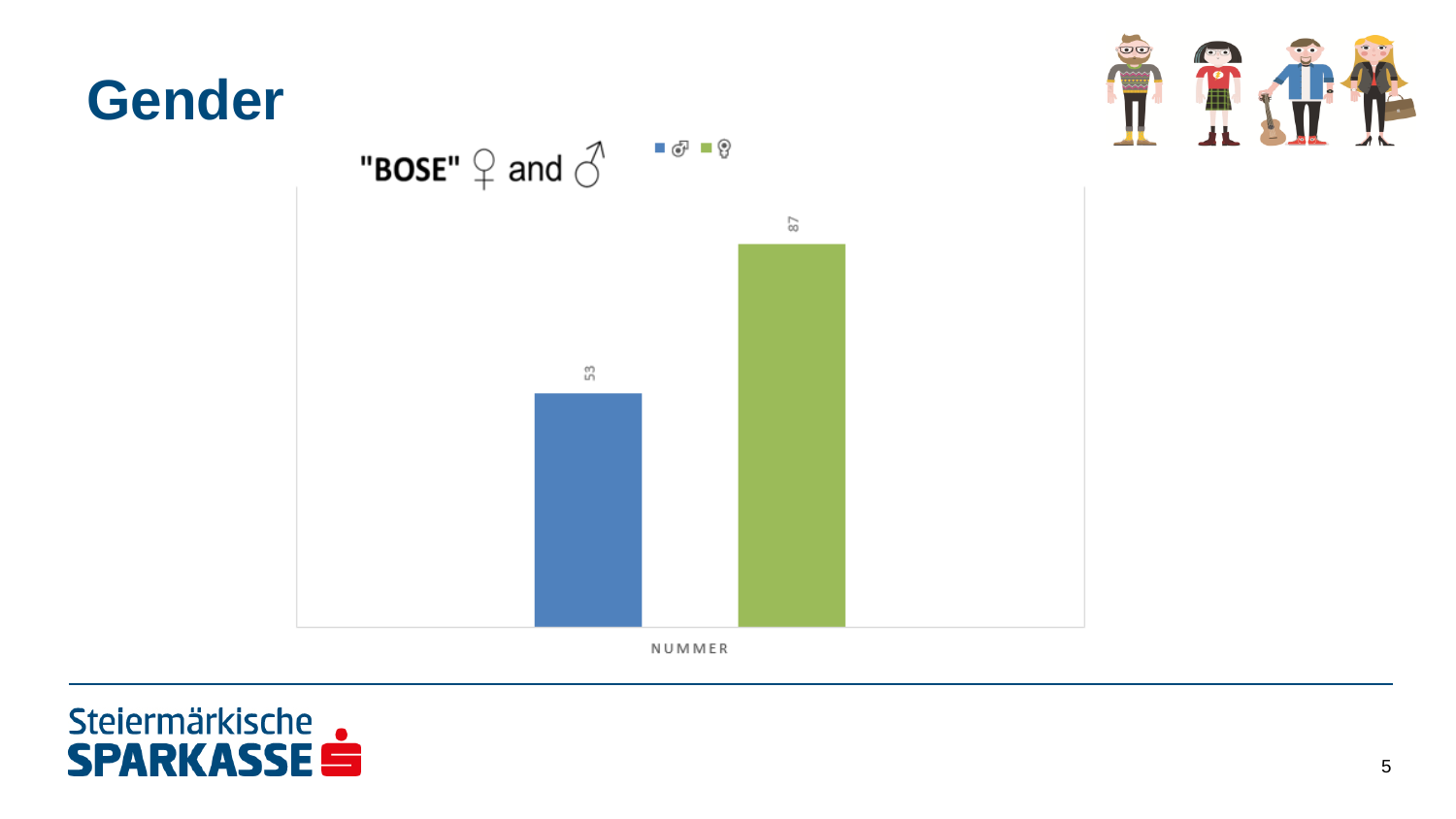
How many bars are plotted in the chart? 2 What is the difference between the female (♀) value and the male (♂) value? 34 What value is shown for the blue (male, ♂) bar? 53 Which series has the higher value, male (♂) or female (♀)? female (♀) What kind of chart is shown on the slide? bar chart Which colour represents the female (♀) series in the legend? green What value is shown for the green (female, ♀) bar? 87 What is the label on the x axis of the chart? NUMMER How many series does the legend list? 2 Is the green bar larger or smaller than the blue bar? larger Which series has the lower value, male (♂) or female (♀)? male (♂) What is the total of the two bar values? 140